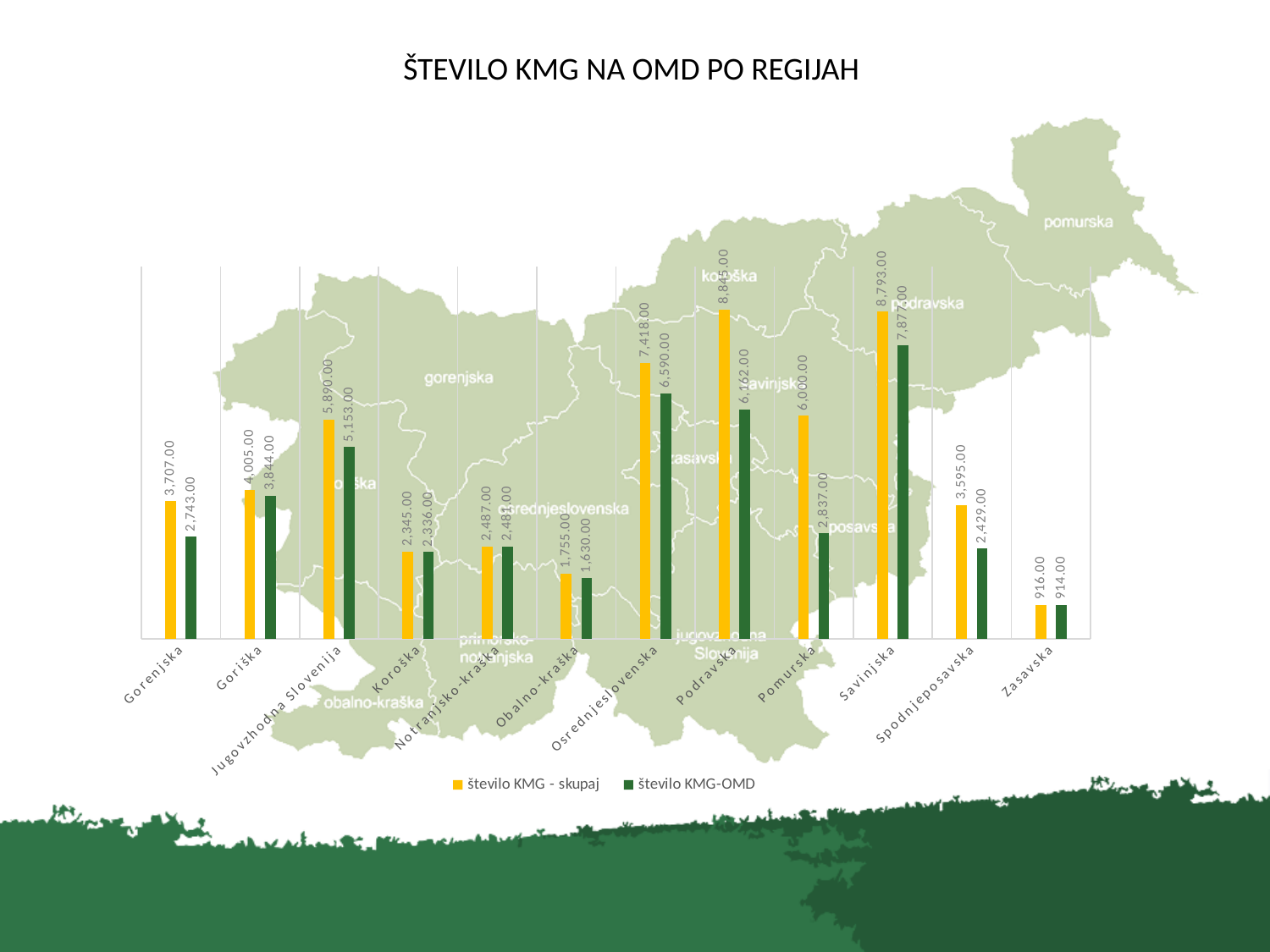
What is the difference between število KMG - skupaj and število KMG-OMD for Gorenjska? 964.00 What is the value of število KMG - skupaj for Zasavska? 916.00 Which is larger: število KMG - skupaj for Pomurska or število KMG-OMD for Osrednjeslovenska? število KMG-OMD for Osrednjeslovenska Which region has the highest value for število KMG-OMD? Savinjska What is the value of število KMG - skupaj for Gorenjska? 3,707.00 What is the difference between število KMG - skupaj and število KMG-OMD for Pomurska? 3,163.00 What kind of chart is shown on the slide? Bar chart What is the value of število KMG-OMD for Pomurska? 2,837.00 What is the value of število KMG-OMD for Savinjska? 7,877.00 Which region has the lowest value for število KMG - skupaj? Zasavska How many regions are shown on the x axis? 12 How many series does the legend list? 2